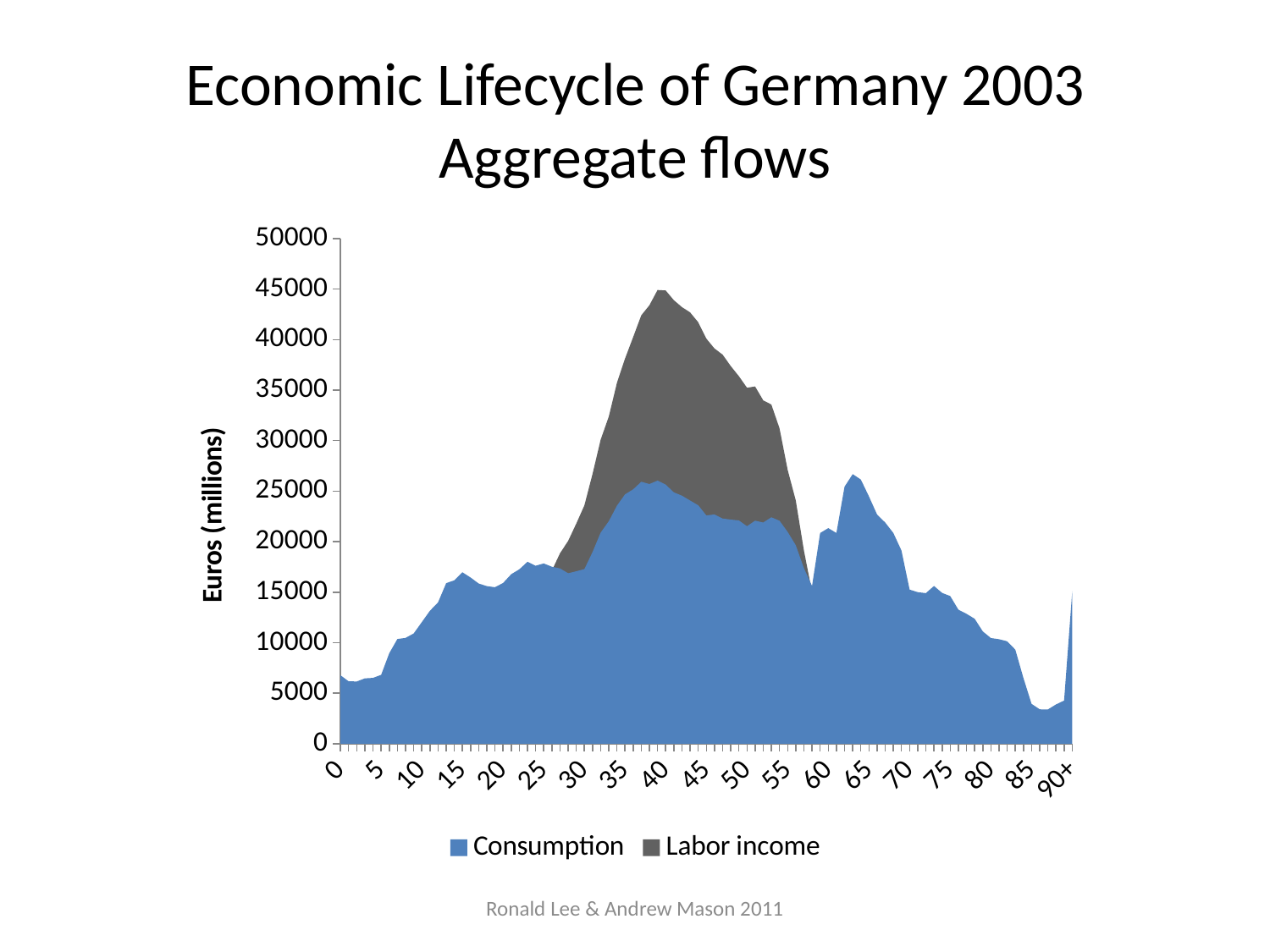
What is the label on the vertical axis? Euros (millions) How many series does the legend list? 2 Does the Labor income area rise or fall between age 40 and age 55? fall Is the value for Consumption at age 65 greater or less than 20000? greater Does Consumption rise or fall between age 0 and age 15? rise Is the value for Consumption at age 40 greater or less than 20000? greater What is the title of the chart? Economic Lifecycle of Germany 2003 Aggregate flows What kind of chart is shown on the slide? area chart Is the value for Consumption at age 0 greater or less than 10000? less